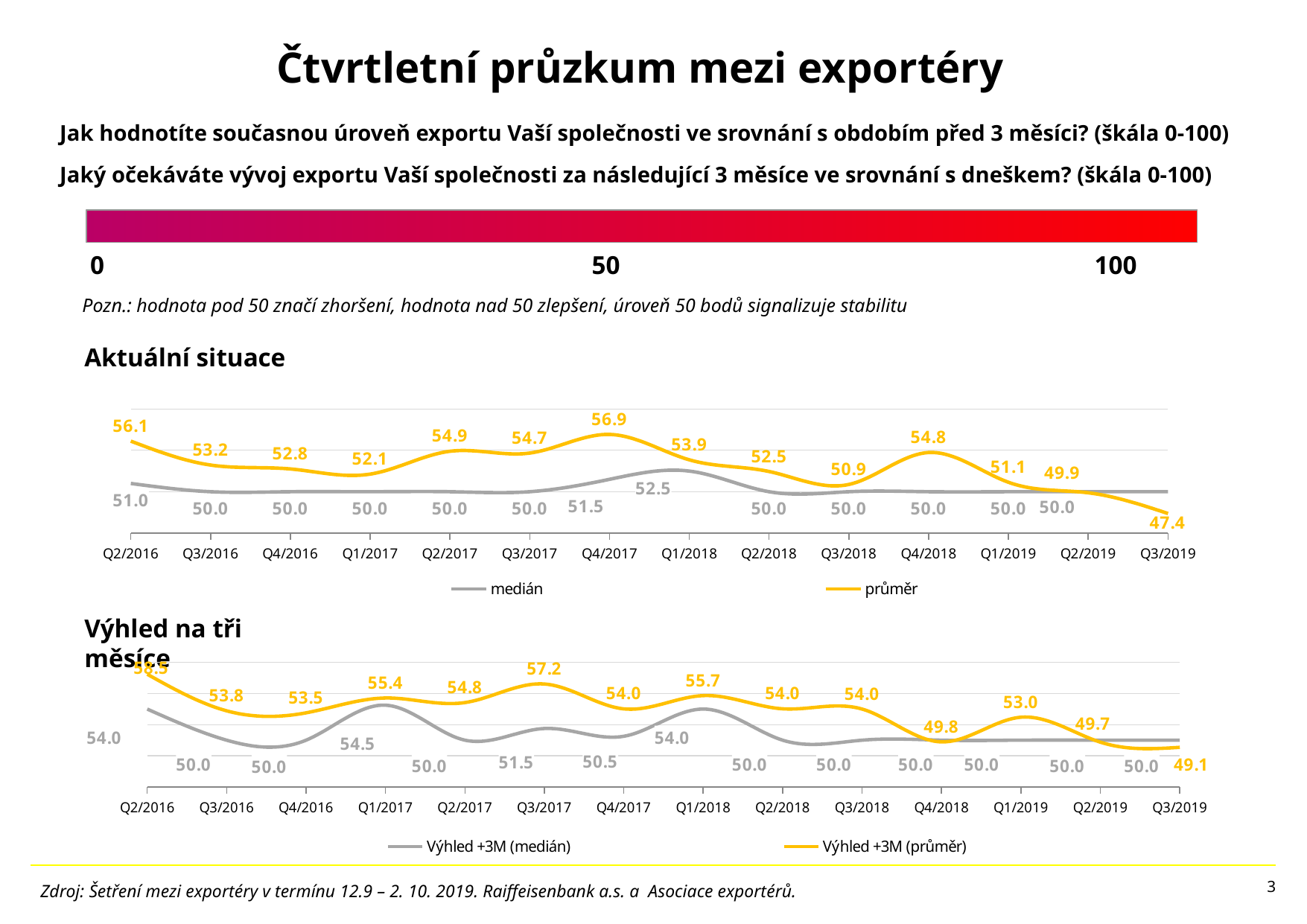
In the 'Aktuální situace' chart, which quarter has the highest průměr value? Q4/2017 In the 'Aktuální situace' chart, what is the průměr value for Q4/2017? 56.9 In the 'Aktuální situace' chart, what is the průměr value for Q3/2019? 47.4 How many series does the legend of the 'Výhled na tři měsíce' chart list? 2 How many quarters are plotted on the x axis of the 'Aktuální situace' chart? 14 In the 'Výhled na tři měsíce' chart, what is the Výhled +3M (průměr) value for Q3/2017? 57.2 In the 'Aktuální situace' chart, which quarter has the lowest průměr value? Q3/2019 What type of chart is the 'Aktuální situace' chart? Line chart In the 'Aktuální situace' chart, what is the medián value for Q1/2018? 52.5 In the 'Aktuální situace' chart, what is the difference between the průměr values for Q2/2016 and Q3/2019? 8.7 In the 'Výhled na tři měsíce' chart, what is the Výhled +3M (medián) value for Q1/2017? 54.5 In the 'Výhled na tři měsíce' chart, which is larger for Q4/2018: the Výhled +3M (průměr) value or the Výhled +3M (medián) value? Výhled +3M (medián)